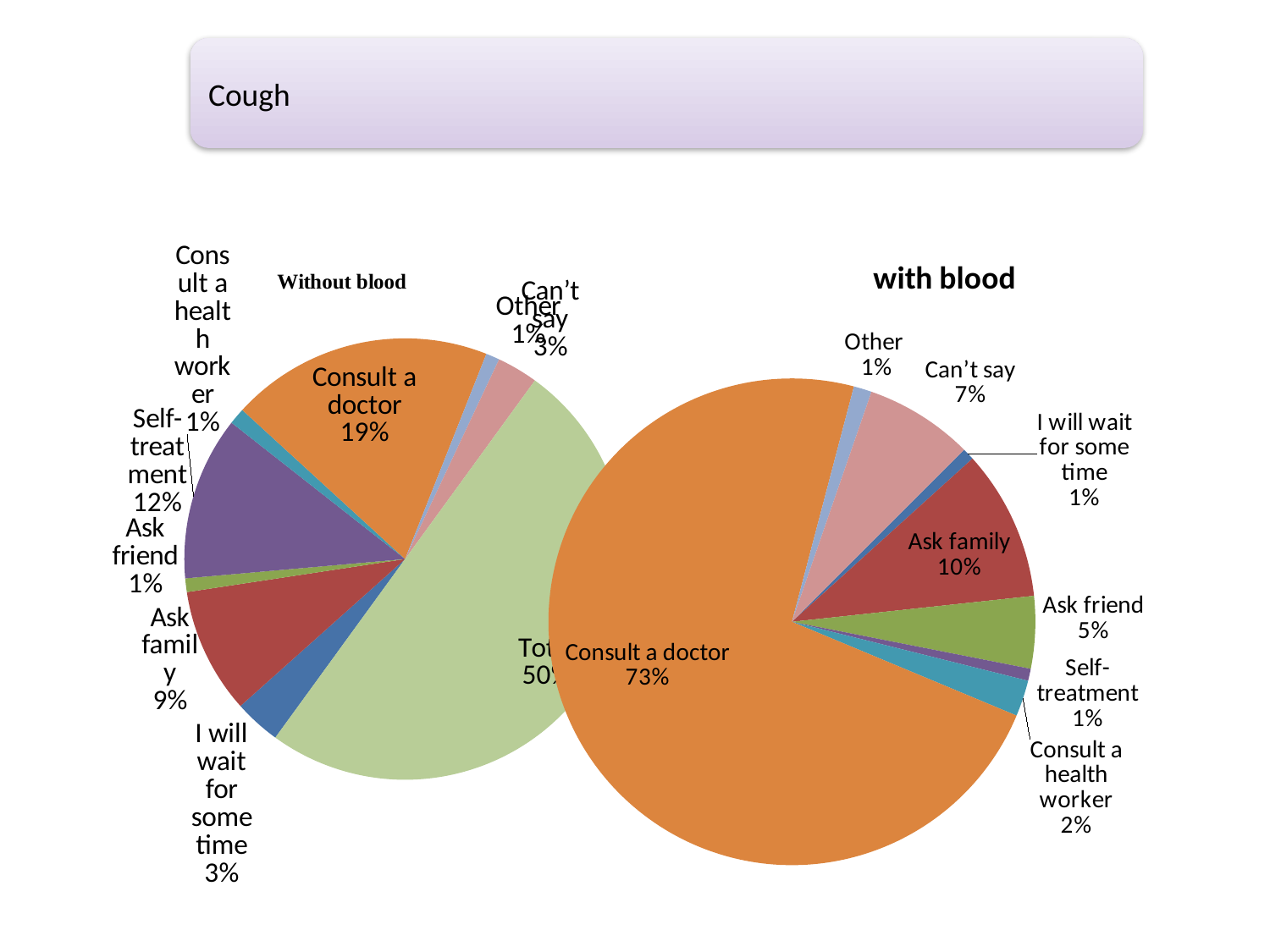
In the 'Without blood' pie chart, what share is labelled for 'Self-treatment'? 12% What is the difference between the 'Consult a doctor' share in the 'with blood' chart and in the 'Without blood' chart? 54 percentage points What is the title of the pie chart on the right? with blood In the 'with blood' pie chart, which category has the largest slice? Consult a doctor In the 'with blood' pie chart, what share is labelled for 'Consult a doctor'? 73% In the 'with blood' pie chart, what share is labelled for 'Can't say'? 7% In the 'Without blood' pie chart, what share is labelled for 'Consult a doctor'? 19% In the 'Without blood' pie chart, what share is labelled for 'Ask family'? 9% Which is larger: 'Ask family' in the 'Without blood' chart or 'Ask family' in the 'with blood' chart? 'with blood' (10%) What type of charts are shown on the slide? Pie charts In the 'with blood' pie chart, what share is labelled for 'Ask friend'? 5% In the 'with blood' pie chart, what is the difference between 'Ask family' and 'Ask friend'? 5 percentage points